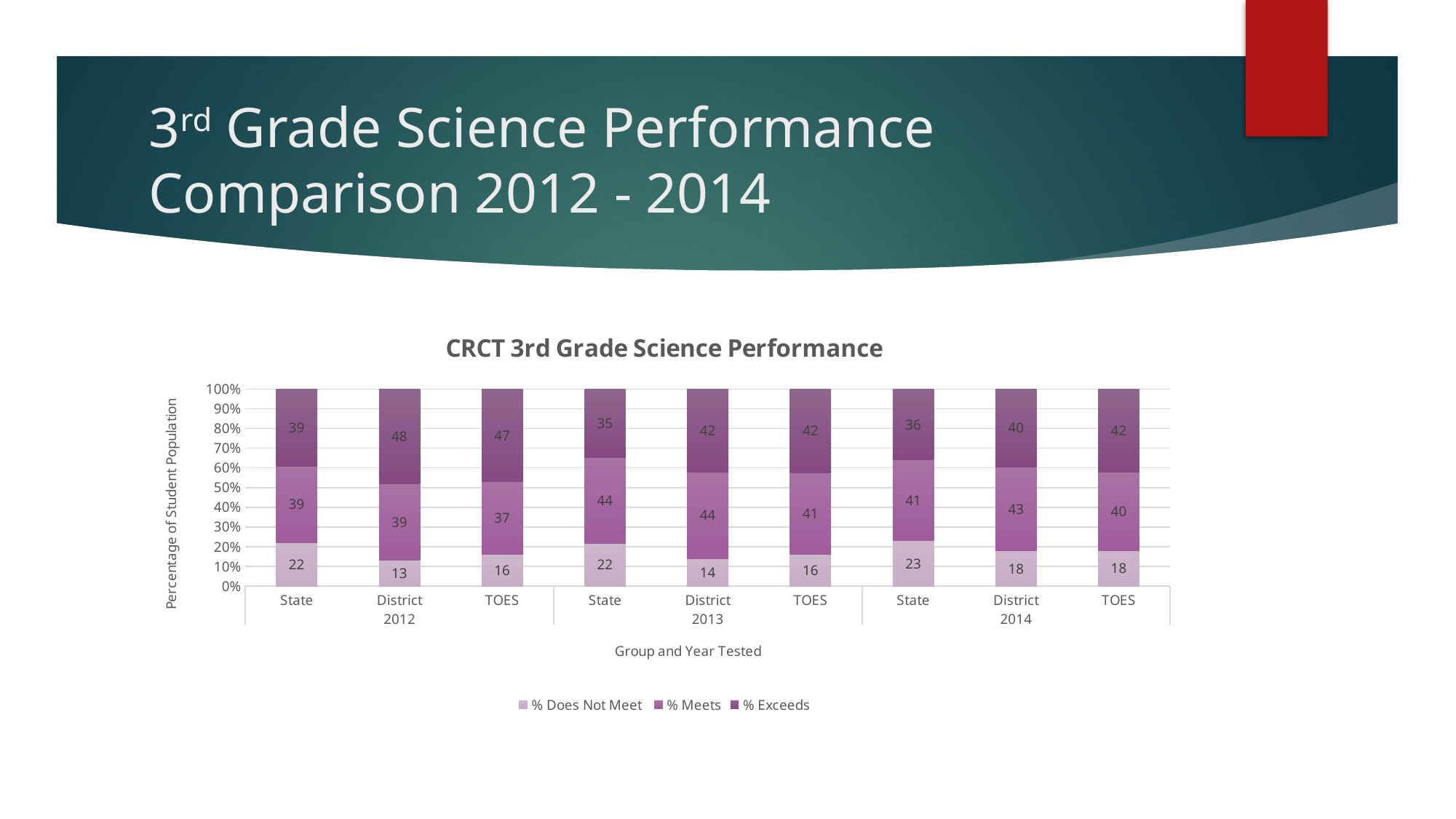
What is the % Does Not Meet value for State in 2014? 23 What is the title of the chart? CRCT 3rd Grade Science Performance Which group and year has the lowest % Does Not Meet value? District 2012 Which is larger, the % Meets value for State in 2013 or the % Meets value for District in 2014? State 2013 What type of chart is shown on the slide? stacked bar chart What is the label of the vertical axis? Percentage of Student Population How many series does the chart legend list? 3 What is the % Exceeds value for District in 2012? 48 Which group and year has the highest % Exceeds value? District 2012 How many bars are plotted in the chart? 9 What is the difference between the % Exceeds values for TOES in 2012 and State in 2012? 8 What is the % Meets value for TOES in 2013? 41